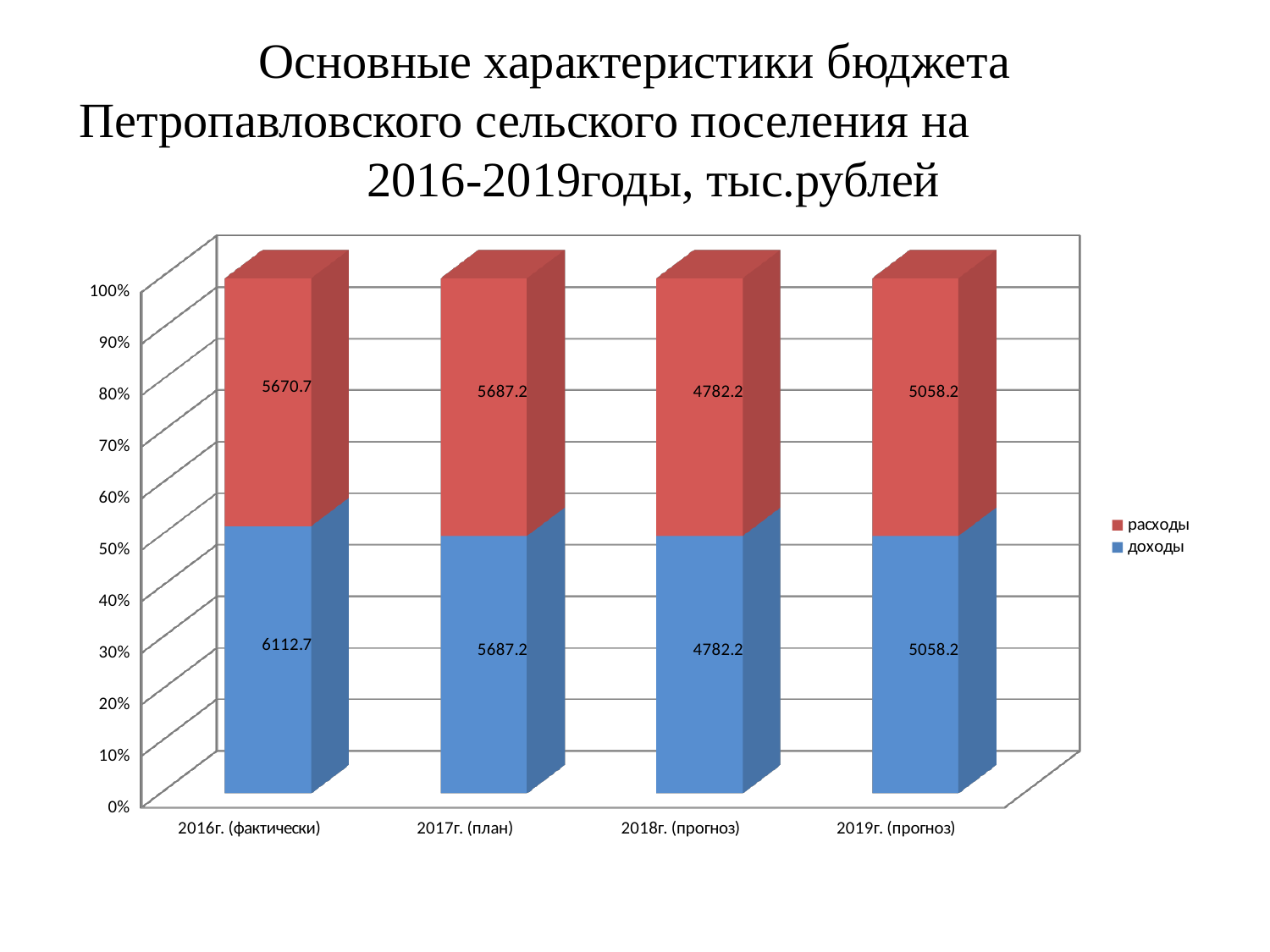
For 2016г. (фактически), which is larger: доходы or расходы? доходы Which category has the highest value for доходы? 2016г. (фактически) Which category has the lowest value for расходы? 2018г. (прогноз) How many categories are shown on the x axis? 4 What is the value of расходы for 2018г. (прогноз)? 4782.2 What is the value of расходы for 2016г. (фактически)? 5670.7 What is the difference between доходы and расходы for 2016г. (фактически)? 442 How many series does the legend list? 2 What is the value of доходы for 2019г. (прогноз)? 5058.2 Which colour represents расходы in the legend? red What is the value of доходы for 2016г. (фактически)? 6112.7 What kind of chart is shown on the slide? stacked bar chart